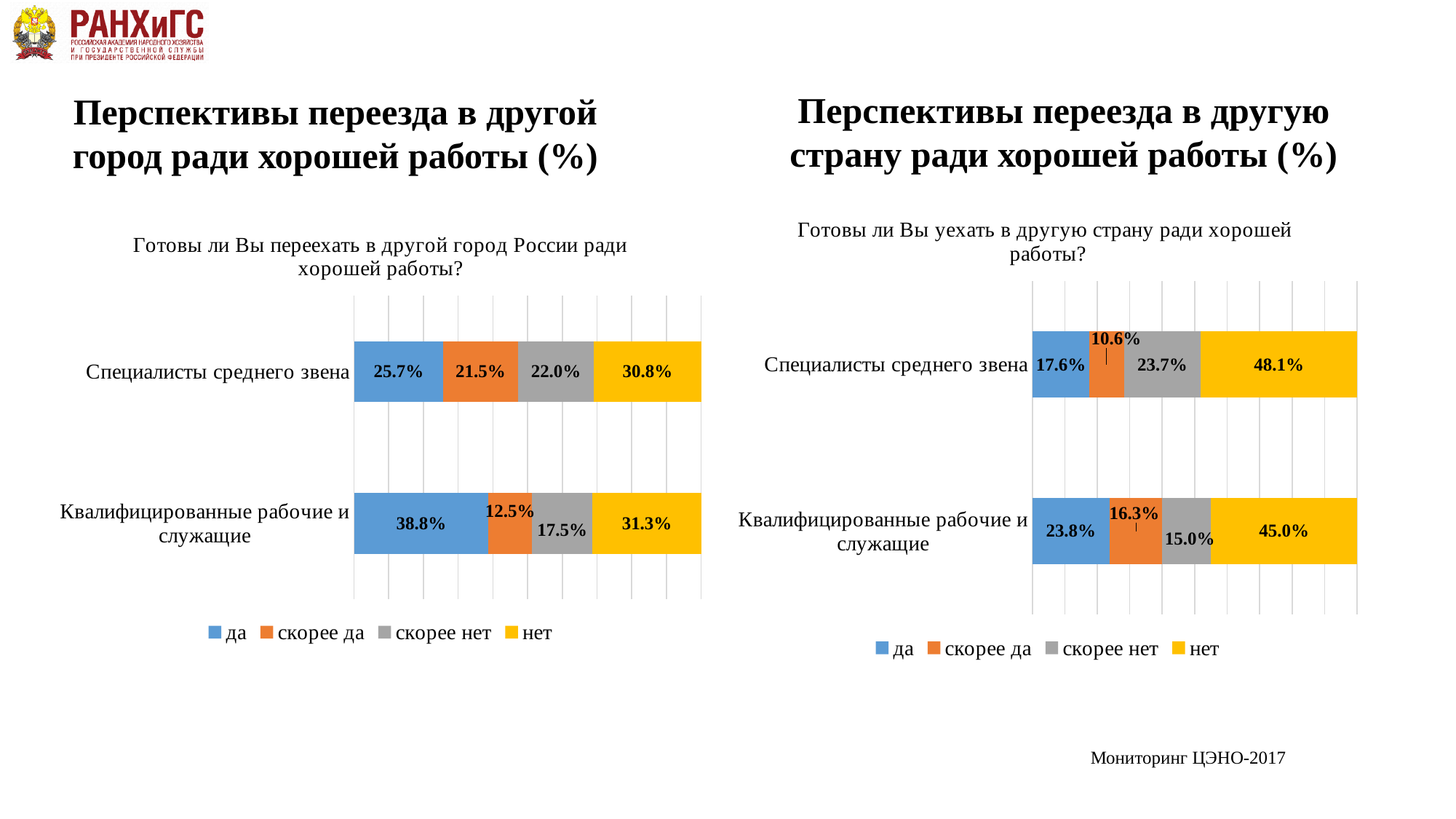
In the left chart (Перспективы переезда в другой город ради хорошей работы), which response category has the highest value for Квалифицированные рабочие и служащие? да In the right chart (Перспективы переезда в другую страну ради хорошей работы), what is the value of 'скорее да' for Квалифицированные рабочие и служащие? 16.3% In the right chart (Перспективы переезда в другую страну ради хорошей работы), which group has the larger 'нет' value: Специалисты среднего звена or Квалифицированные рабочие и служащие? Специалисты среднего звена In the left chart (Перспективы переезда в другой город ради хорошей работы), what is the value of 'да' for Квалифицированные рабочие и служащие? 38.8% In the left chart (Перспективы переезда в другой город ради хорошей работы), what is the value of 'нет' for Специалисты среднего звена? 30.8% In the right chart (Перспективы переезда в другую страну ради хорошей работы), which response category has the lowest value for Специалисты среднего звена? скорее да In the right chart (Перспективы переезда в другую страну ради хорошей работы), what colour represents the 'нет' series? Yellow How many groups (categories) are shown in the right chart (Перспективы переезда в другую страну ради хорошей работы)? 2 In the right chart (Перспективы переезда в другую страну ради хорошей работы), what is the value of 'нет' for Специалисты среднего звена? 48.1% In the left chart (Перспективы переезда в другой город ради хорошей работы), what is the difference between the 'да' values for Квалифицированные рабочие и служащие and Специалисты среднего звена? 13.1% How many series does the legend of the left chart (Перспективы переезда в другой город ради хорошей работы) list? 4 What type of chart is the left chart (Перспективы переезда в другой город ради хорошей работы)? Stacked bar chart